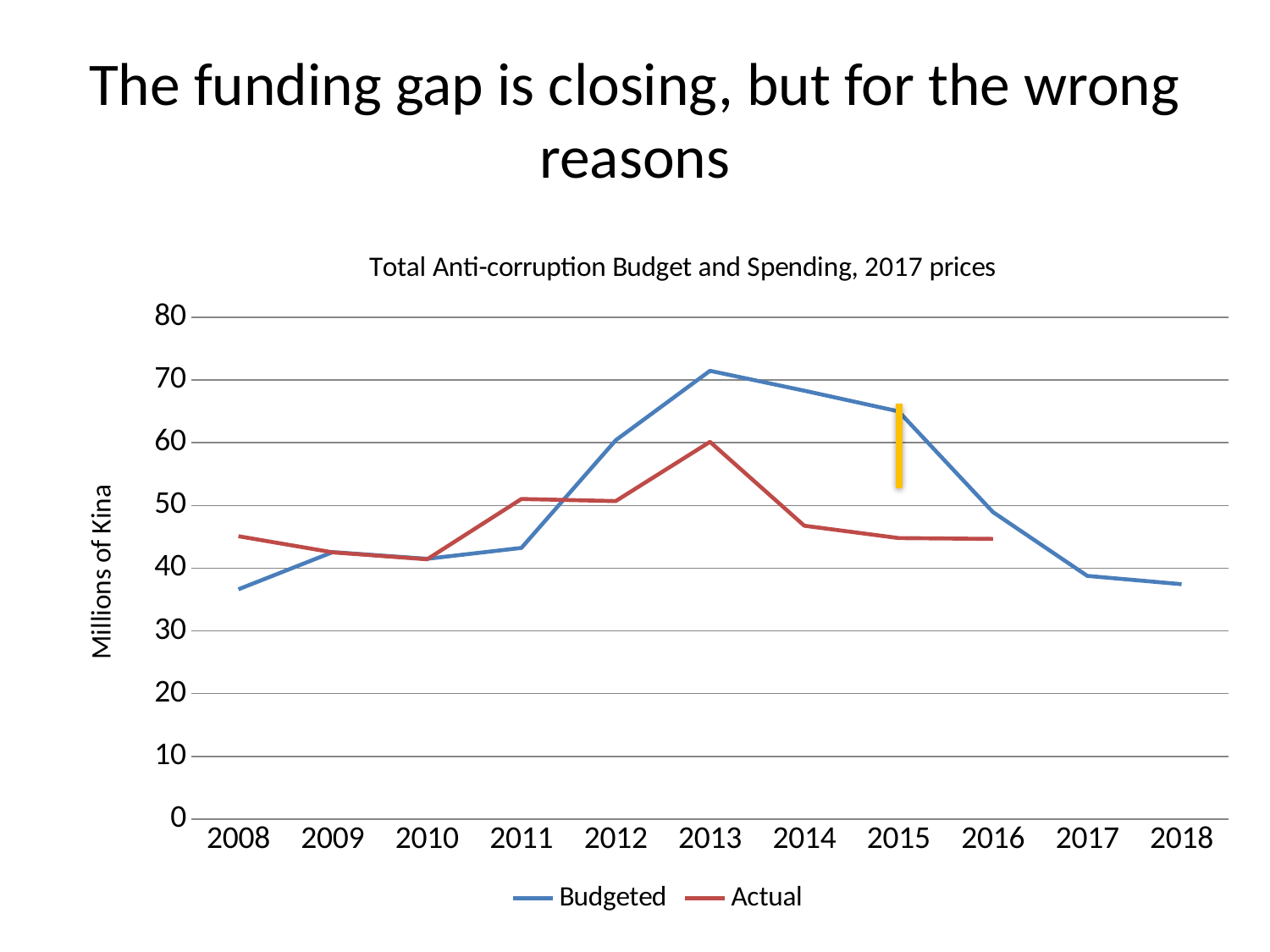
Does the Budgeted series rise or fall from 2013 to 2018? Fall Is the Budgeted value for 2013 greater or less than 60? greater What kind of chart is shown on the slide? Line chart How many years are shown on the x axis? 11 In which year does the Actual series reach its highest value? 2013 In 2011, which is larger, the Budgeted value or the Actual value? Actual What is the label on the y axis? Millions of Kina Is the Actual value for 2014 greater or less than 50? less How many series does the legend list? 2 Is the Budgeted value for 2017 greater or less than 40? less In which year does the Budgeted series reach its highest value? 2013 In 2015, which is larger, the Budgeted value or the Actual value? Budgeted